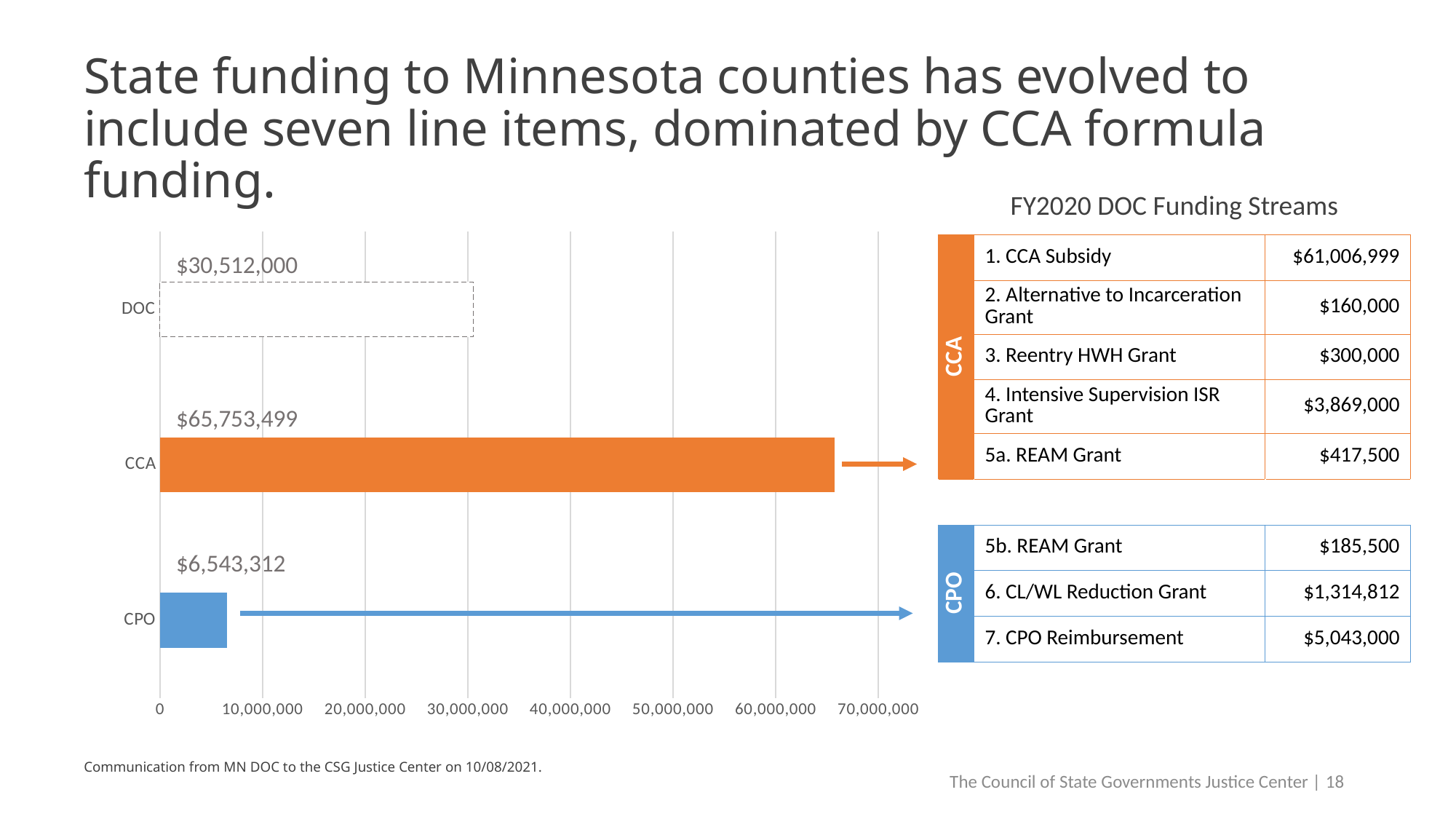
What colour is the CCA bar in the chart? orange What is the value of the CPO bar in the chart? $6,543,312 Which category has the highest value in the chart? CCA What is the difference between the DOC value and the CPO value in the chart? $23,968,688 What is the value of the DOC bar in the chart? $30,512,000 What is the difference between the CCA value and the DOC value in the chart? $35,241,499 Which is larger in the chart, the DOC value or the CPO value? DOC What is the value of the CCA bar in the chart? $65,753,499 What kind of chart is shown on the left of the slide? bar chart How many categories are shown in the bar chart? 3 Is the value for CCA greater or less than 60,000,000? greater Which category has the lowest value in the chart? CPO